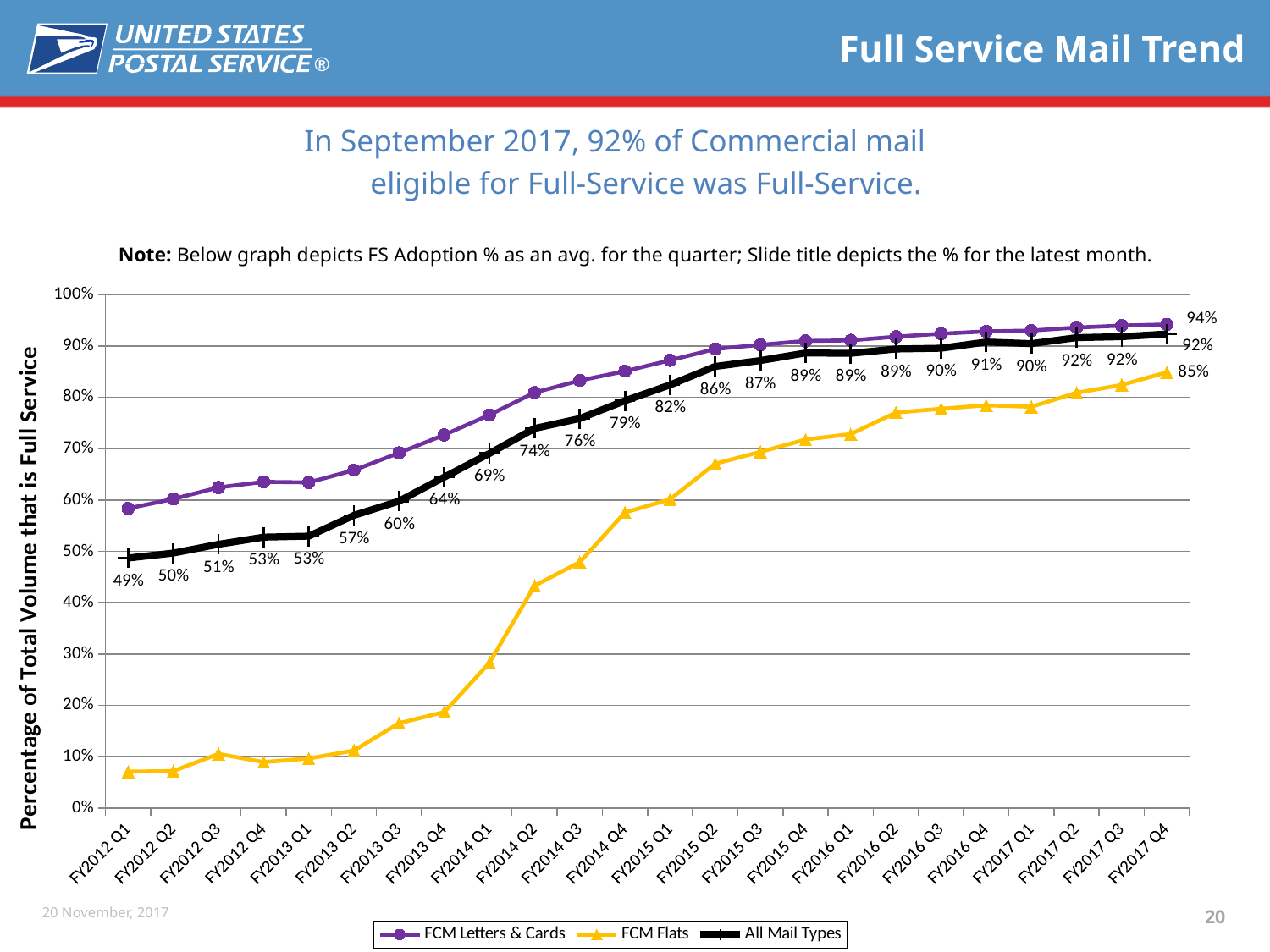
Which series has the lowest value in FY2012 Q1? FCM Flats What is the label on the y axis? Percentage of Total Volume that is Full Service How many quarters are plotted along the x axis? 24 What is the All Mail Types value for FY2014 Q2? 74% What is the FCM Flats value for FY2017 Q4? 85% What is the FCM Letters & Cards value for FY2017 Q4? 94% What is the difference between the All Mail Types values for FY2017 Q4 and FY2012 Q1? 43% Does the All Mail Types series generally rise or fall from FY2012 Q1 to FY2017 Q4? rise What is the All Mail Types value for FY2012 Q1? 49% Is the FCM Flats value for FY2014 Q1 greater or less than 30%? less What type of chart is shown on the slide? line chart How many series does the legend list? 3